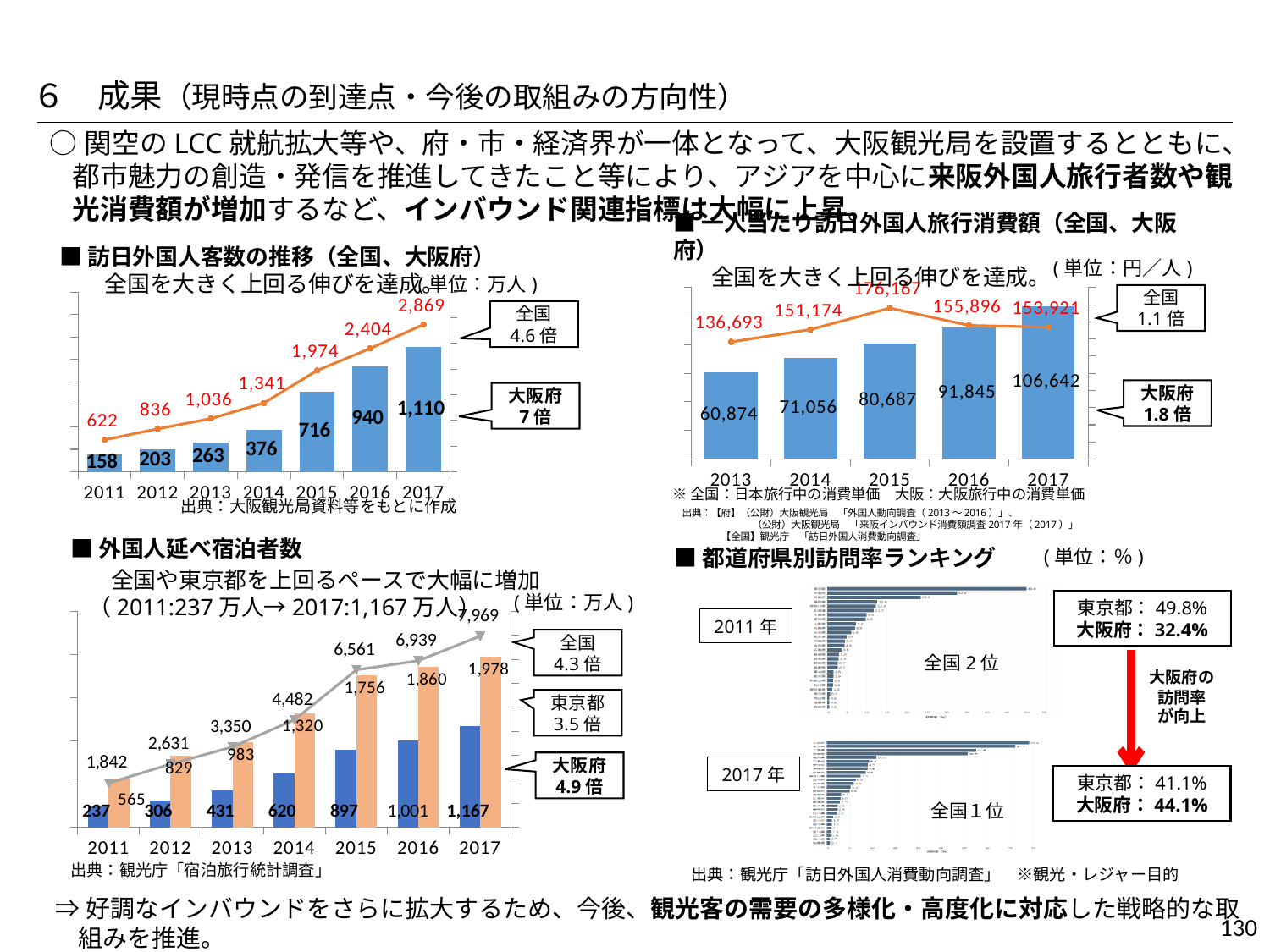
In the chart titled 一人当たり訪日外国人旅行消費額（全国、大阪府）, what is the 大阪府 value for 2015? 80,687 In the chart titled 一人当たり訪日外国人旅行消費額（全国、大阪府）, in which year is the 全国 value highest? 2015 In the chart titled 一人当たり訪日外国人旅行消費額（全国、大阪府）, do the 大阪府 bar values rise or fall from 2013 to 2017? rise In the chart titled 外国人延べ宿泊者数, what is the 全国 value for 2015? 6,561 In the chart titled 一人当たり訪日外国人旅行消費額（全国、大阪府）, what is the difference between the 全国 value and the 大阪府 value in 2017? 47,279 In the chart titled 外国人延べ宿泊者数, which is larger in 2014, the 大阪府 value or the 東京都 value? 東京都 In the chart titled 訪日外国人客数の推移（全国、大阪府）, what is the difference between the 全国 value and the 大阪府 value in 2011? 464 In the chart titled 外国人延べ宿泊者数, what is the 東京都 value for 2016? 1,860 In the chart titled 訪日外国人客数の推移（全国、大阪府）, what is the 全国 value for 2014? 1,341 In the chart titled 訪日外国人客数の推移（全国、大阪府）, how many years are shown on the x axis? 7 In the chart titled 訪日外国人客数の推移（全国、大阪府）, what is the 大阪府 value for 2017? 1,110 What kind of chart is the one titled 外国人延べ宿泊者数? bar chart with a line